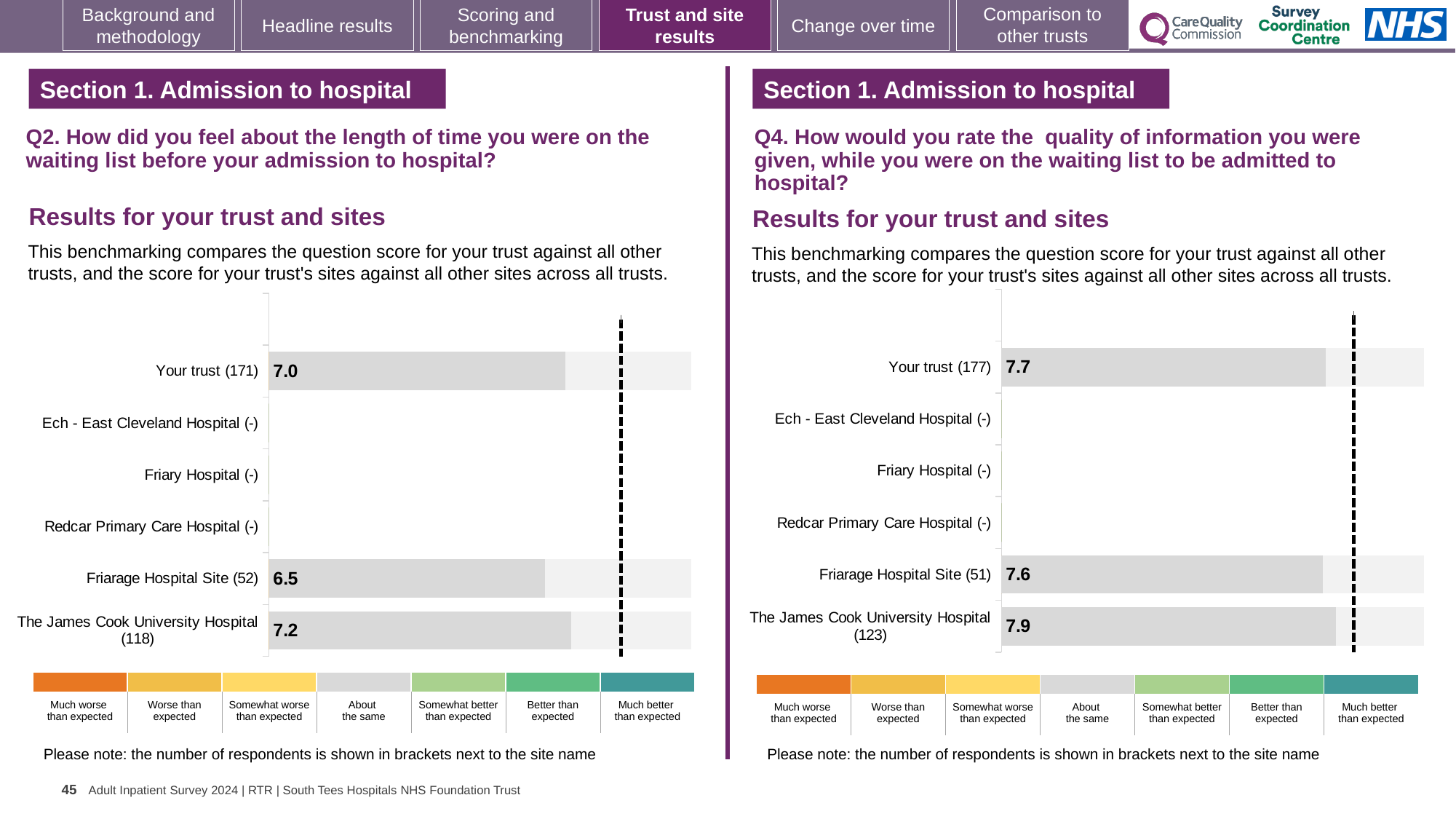
How many site/trust categories are listed on the y axis of the Q2 chart on the left? 6 In the Q4 chart on the right, what is the score for The James Cook University Hospital (123)? 7.9 In the Q2 chart on the left, what is the score for The James Cook University Hospital (118)? 7.2 What kind of chart is used on the right for Q4? Bar chart In the Q2 chart on the left, what is the difference between the scores for The James Cook University Hospital (118) and Friarage Hospital Site (52)? 0.7 In the Q4 chart on the right, which site has the highest score shown? The James Cook University Hospital (123) In the Q2 chart on the left, which site has the lowest score shown? Friarage Hospital Site (52) In the Q4 chart on the right, what is the score for Friarage Hospital Site (51)? 7.6 In the Q4 chart on the right, what is the score for Your trust (177)? 7.7 In the Q2 chart on the left, what is the score for Your trust (171)? 7.0 In the Q4 chart on the right, what is the difference between the scores for The James Cook University Hospital (123) and Your trust (177)? 0.2 In the Q2 chart on the left, what is the score for Friarage Hospital Site (52)? 6.5